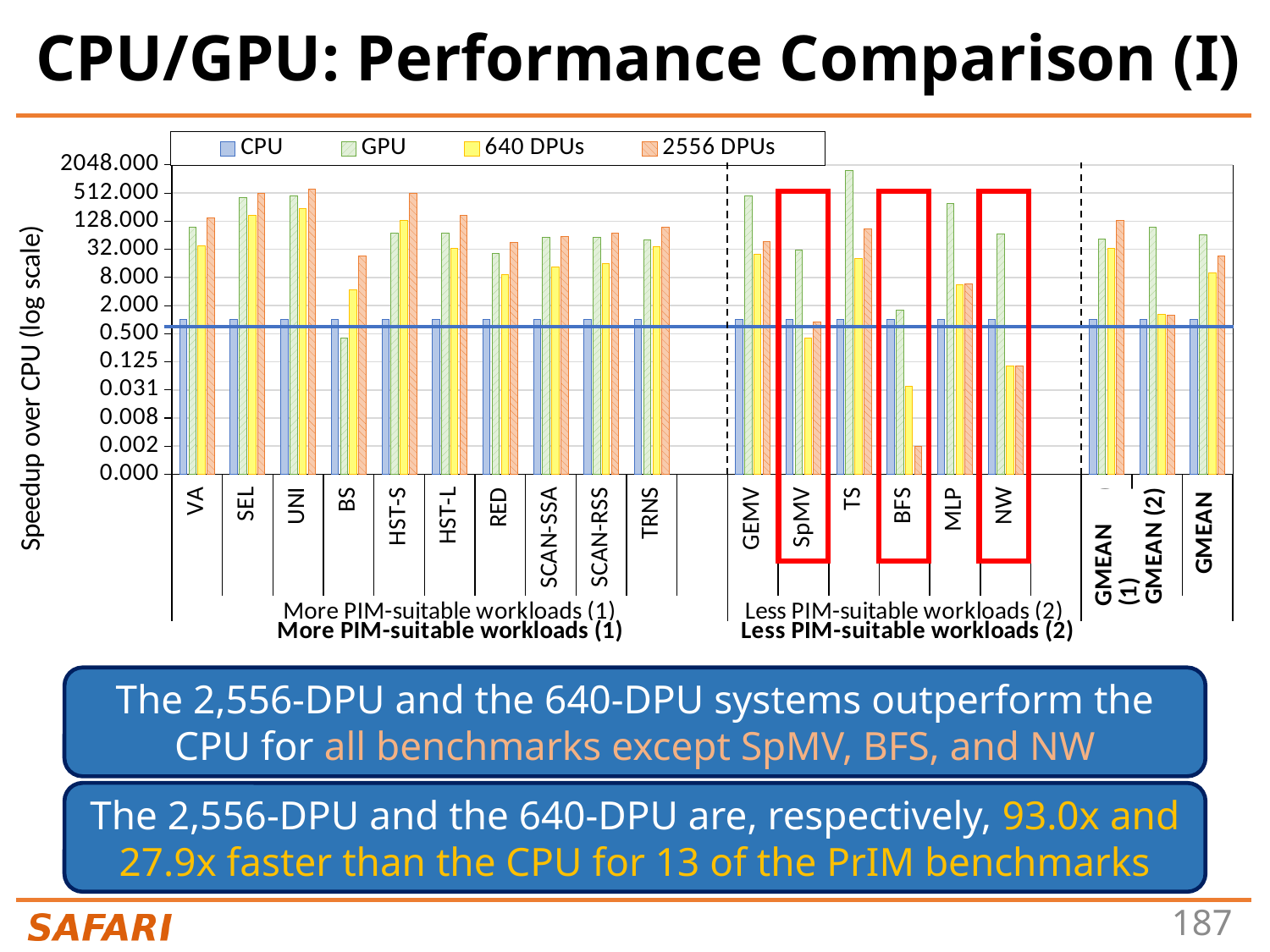
Is the 2556 DPUs value for BFS greater or less than 0.008? less Which benchmark has the lowest 2556 DPUs bar? BFS What is the label of the y axis? Speedup over CPU (log scale) Which three benchmarks are highlighted with red boxes on the chart? SpMV, BFS, and NW Which benchmark has the highest GPU bar? TS Is the 640 DPUs value for NW greater or less than 0.500? less What kind of chart is shown on the slide? bar chart How many benchmark categories (including the GMEAN bars) are shown along the x axis? 19 For TS, which series has the higher value: GPU or 2556 DPUs? GPU Is the 2556 DPUs value for SEL greater or less than 128.000? greater How many series does the chart legend list? 4